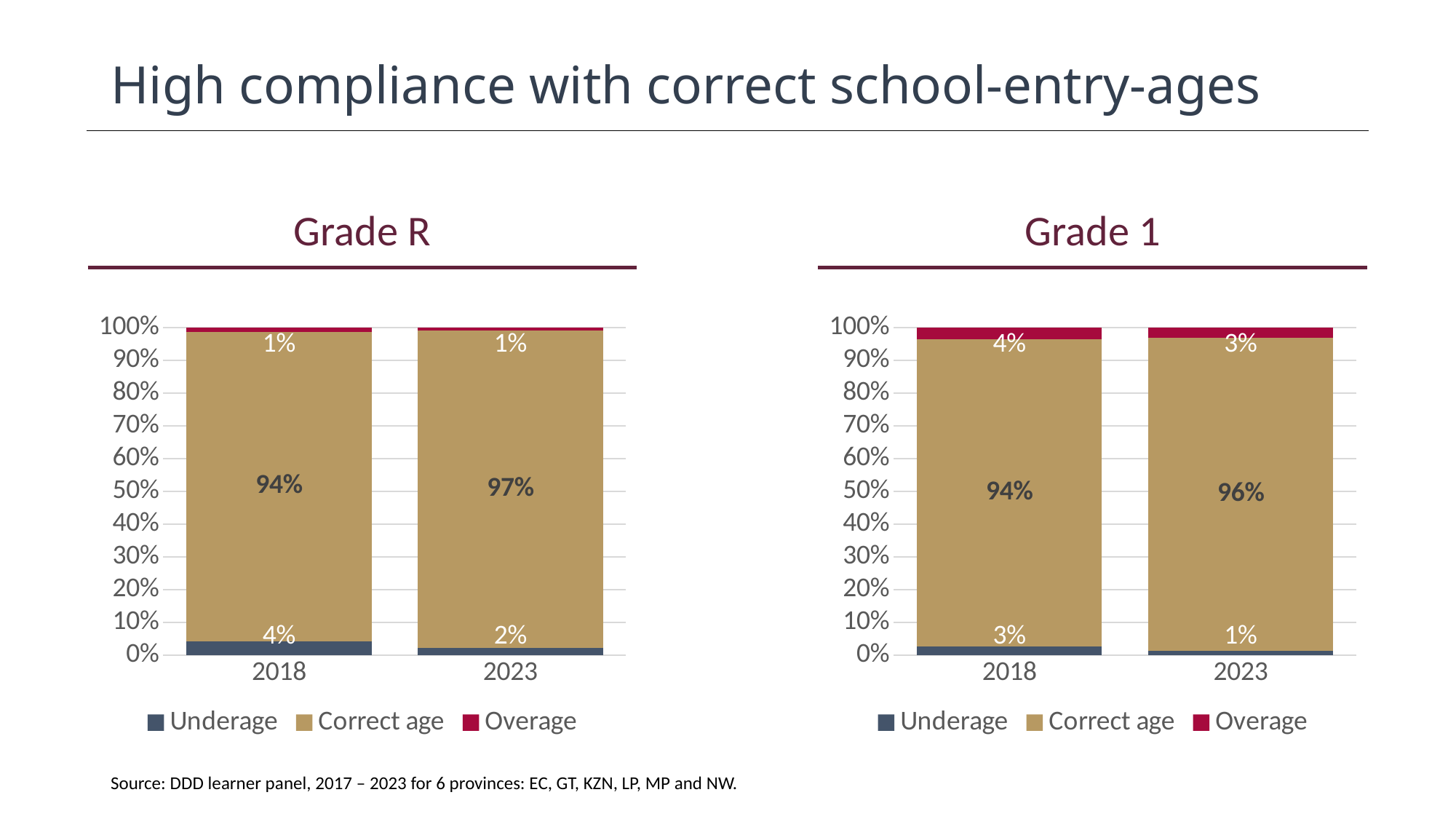
In the Grade 1 chart, what is the Underage value for 2023? 1% In the Grade R chart, which year has the higher Correct age value? 2023 In the Grade R chart, what is the Correct age value for 2023? 97% In the Grade 1 chart, is the Underage value for 2018 larger or smaller than the Underage value for 2023? larger How many series does the legend of the Grade R chart list? 3 In the Grade 1 chart, which year has the lower Overage value? 2023 In the Grade R chart, what is the Underage value for 2018? 4% In the Grade R chart, what is the difference between the Correct age values for 2023 and 2018? 3% In the Grade 1 chart, does the Correct age value rise or fall from 2018 to 2023? rise What kind of chart is the Grade R chart? Stacked bar chart How many years are shown on the x axis of the Grade 1 chart? 2 In the Grade 1 chart, what is the Overage value for 2018? 4%